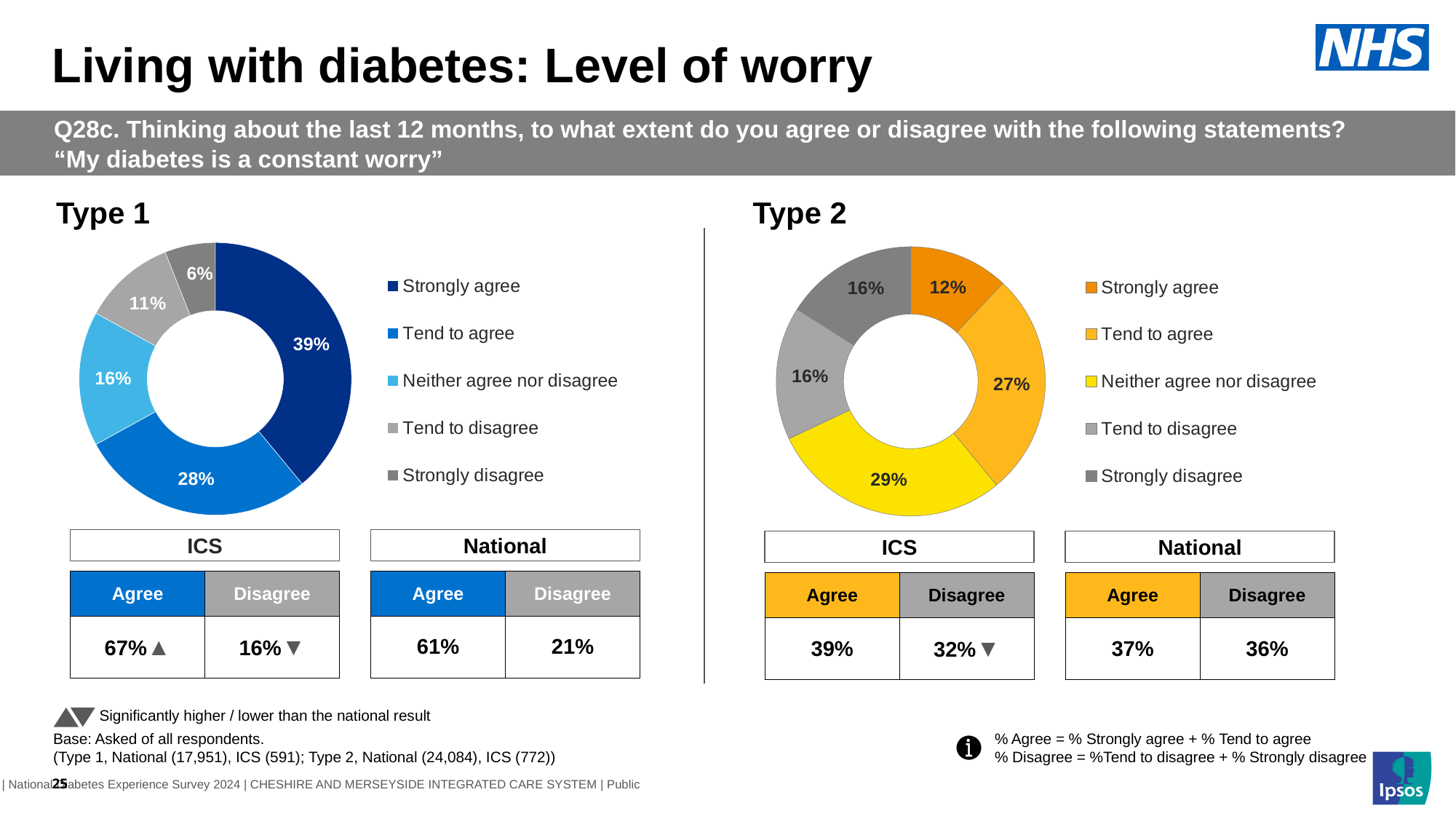
How many response categories does the legend of the Type 2 chart list? 5 In the Type 2 chart, which is larger: Tend to agree or Strongly agree? Tend to agree In the Type 2 chart, which response category has the smallest share? Strongly agree In the Type 1 chart, what is the difference in percentage points between Strongly agree and Tend to agree? 11 In the Type 2 chart, what percentage of respondents strongly agree? 12% In the Type 1 chart, which response category has the smallest share? Strongly disagree What kind of chart is used to show the Type 1 results? Doughnut (pie) chart In the Type 2 chart, which response category has the largest share? Neither agree nor disagree In the Type 2 chart, what percentage of respondents neither agree nor disagree? 29% In the Type 1 chart, which response category has the largest share? Strongly agree In the Type 1 chart, what percentage of respondents strongly agree? 39% In the Type 1 chart, what percentage of respondents tend to disagree? 11%